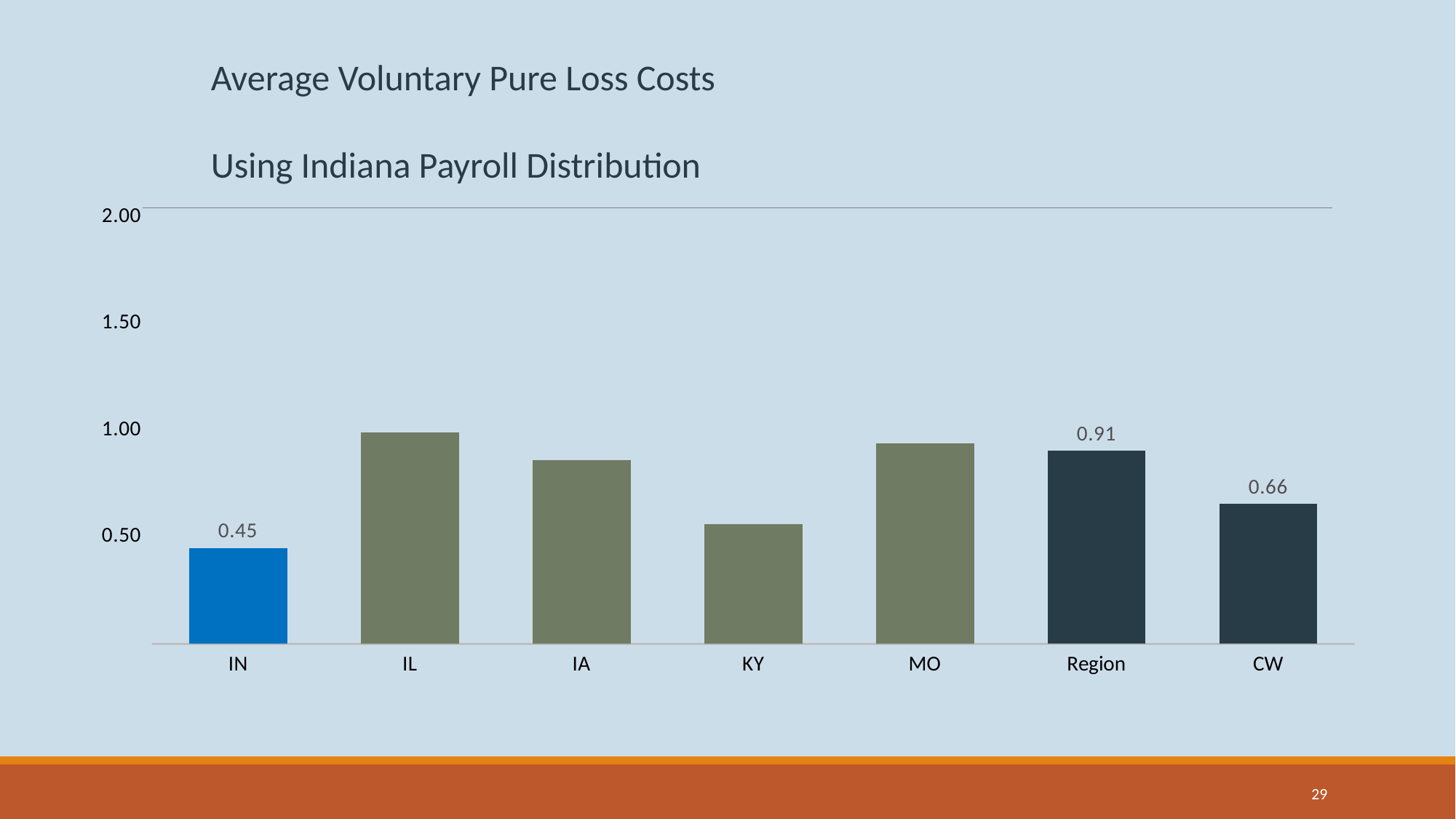
What is the difference between the values for Region and IN? 0.46 Is the value for MO greater or less than 1.00? less Which category has the lowest value? IN What is the value for IN? 0.45 What is the value for CW? 0.66 What is the value for Region? 0.91 Which is larger, the value for KY or the value for IN? KY What is the title of the chart? Average Voluntary Pure Loss Costs Using Indiana Payroll Distribution How many categories are shown on the x axis? 7 What kind of chart is shown on the slide? bar chart Is the value for IL greater or less than 0.50? greater What is the difference between the values for Region and CW? 0.25